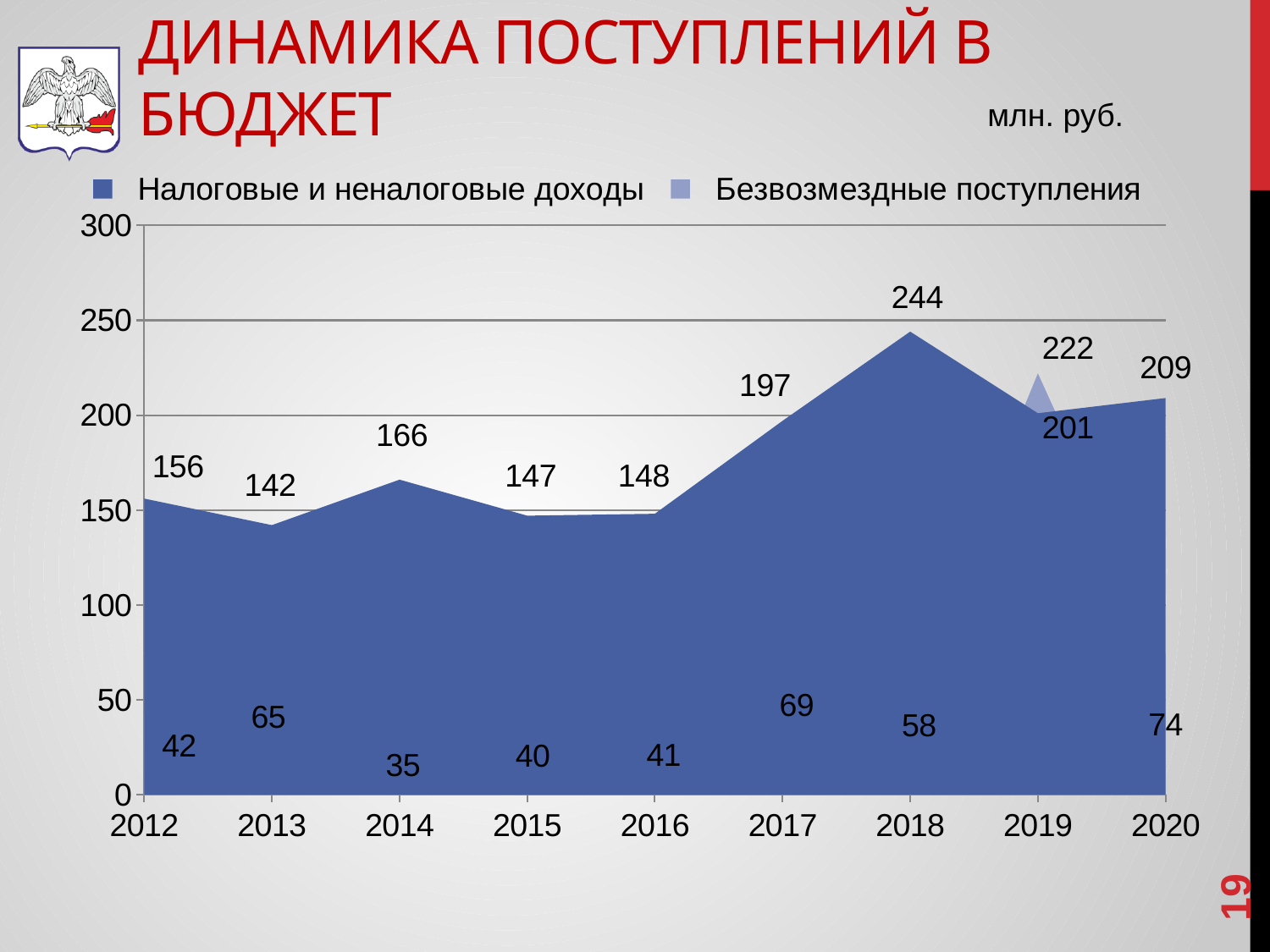
Do the values of Налоговые и неналоговые доходы rise or fall from 2016 to 2018? rise How many series does the legend list? 2 What is the value of Налоговые и неналоговые доходы in 2018? 244 In which year is Налоговые и неналоговые доходы lowest? 2013 What type of chart is shown on the slide? area chart How many years are shown on the x axis? 9 What is the value of Налоговые и неналоговые доходы in 2012? 156 What is the value of Безвозмездные поступления in 2020? 74 What is the value of Безвозмездные поступления in 2013? 65 Which year has the larger value of Налоговые и неналоговые доходы, 2014 or 2015? 2014 What is the difference between Налоговые и неналоговые доходы in 2018 and 2017? 47 In which year is Налоговые и неналоговые доходы highest? 2018